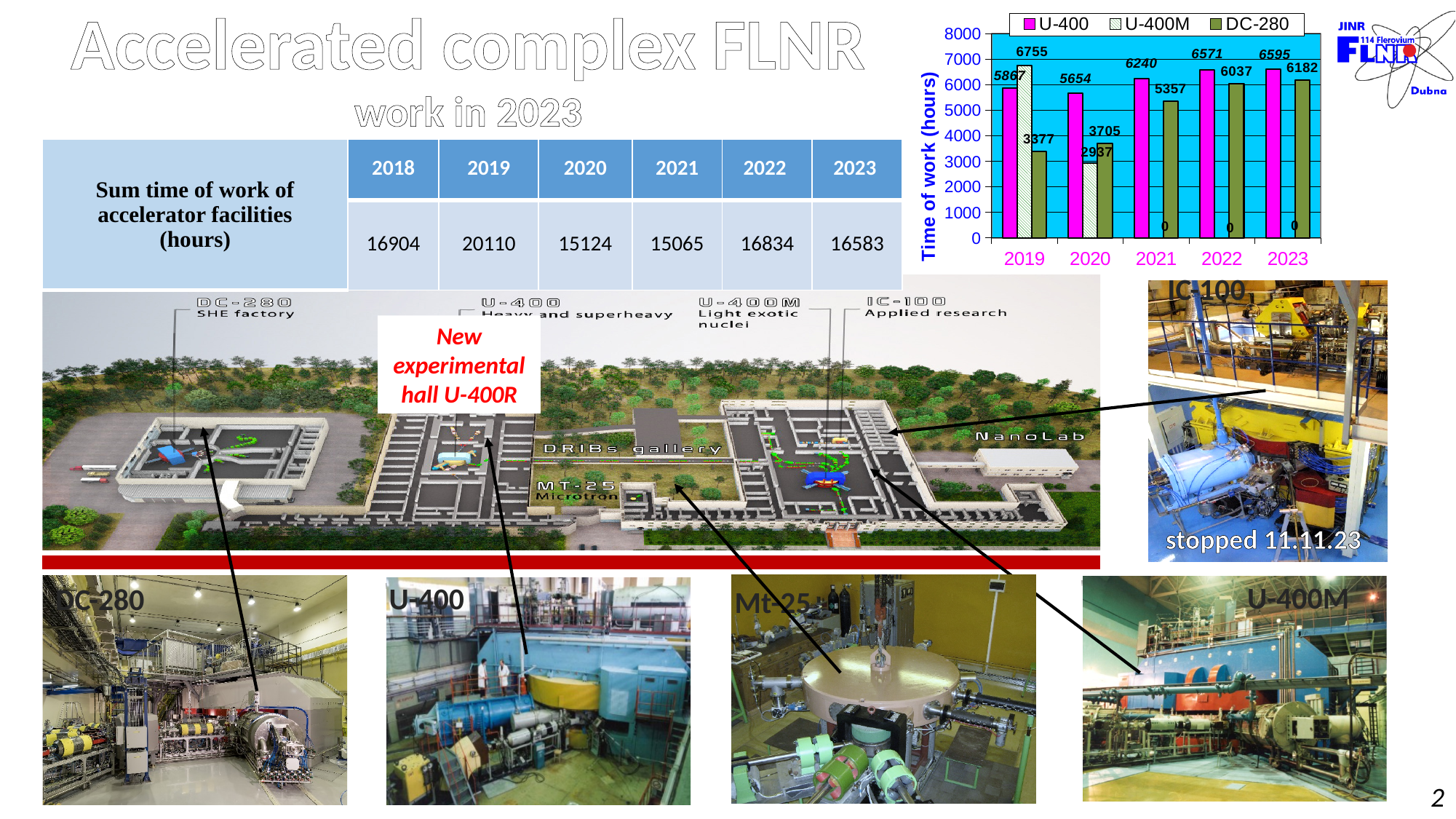
In the bar chart, what is the time of work for U-400M in 2019? 6755 In the bar chart, what is the difference between the U-400 and DC-280 values in 2020? 1949 In the bar chart, what is the time of work for U-400 in 2023? 6595 In the bar chart, which year has the lowest value for U-400? 2020 In the bar chart, what is the time of work for DC-280 in 2021? 5357 In the bar chart, which year has the highest value for DC-280? 2023 In the bar chart, does the DC-280 value rise or fall from 2019 to 2023? rise How many years are shown on the x axis of the bar chart? 5 What kind of chart is shown in the top right of the slide? bar chart How many series does the legend of the bar chart list? 3 In the bar chart, which is larger in 2019: U-400 or U-400M? U-400M What is the label of the y axis of the bar chart? Time of work (hours)